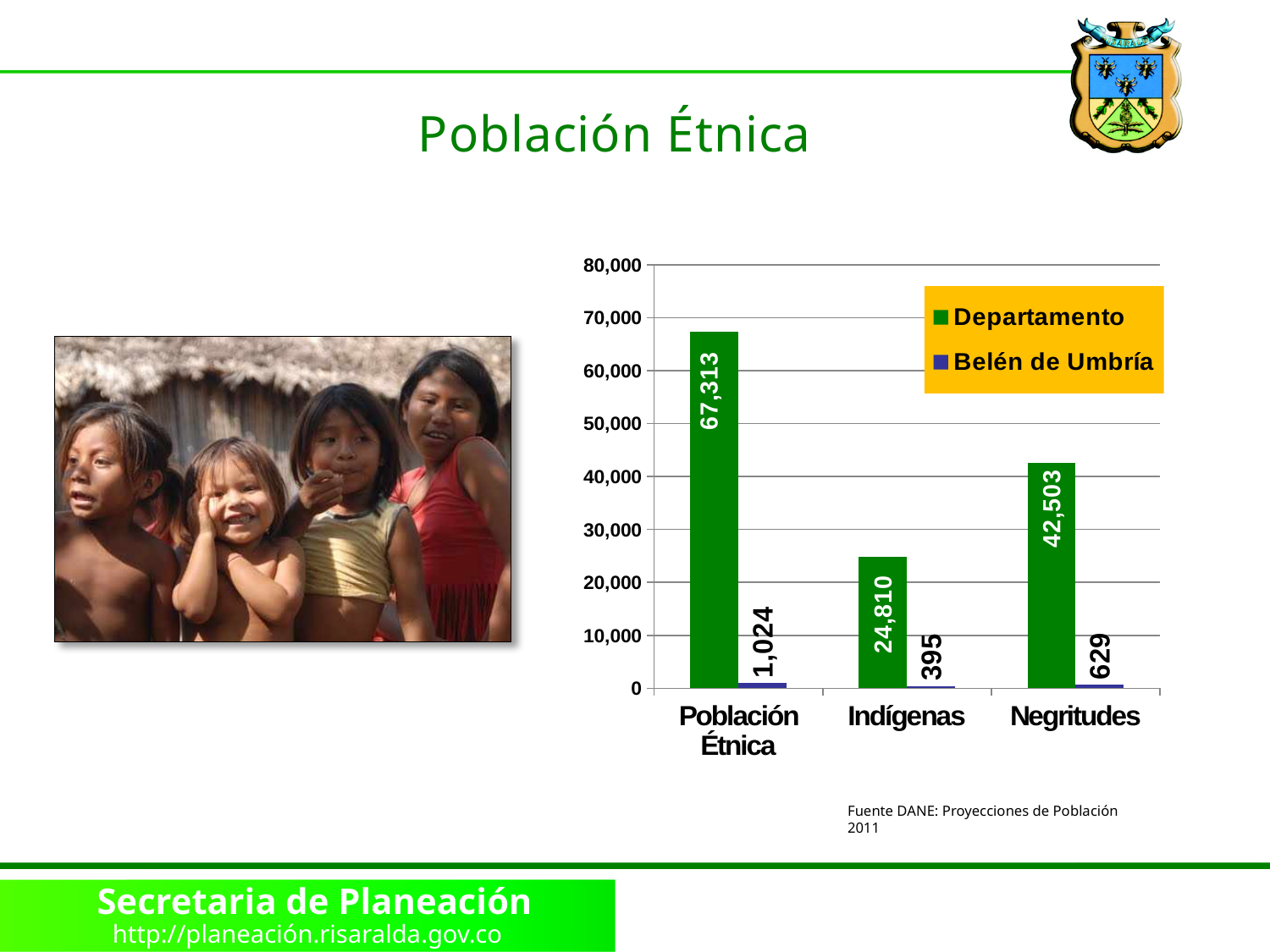
What is the Belén de Umbría value for Indígenas? 395 How many series does the legend list? 2 What kind of chart is shown on the slide? bar chart What is the Departamento value for Negritudes? 42,503 Which category has the lowest Belén de Umbría value? Indígenas Is the Departamento value for Indígenas greater or less than 30,000? less Which is larger, the Belén de Umbría value for Negritudes or for Indígenas? Negritudes What is the difference between the Departamento values for Negritudes and Indígenas? 17,693 Which category has the highest Departamento value? Población Étnica What is the Belén de Umbría value for Población Étnica? 1,024 What is the Departamento value for Población Étnica? 67,313 How many categories are shown on the x axis? 3